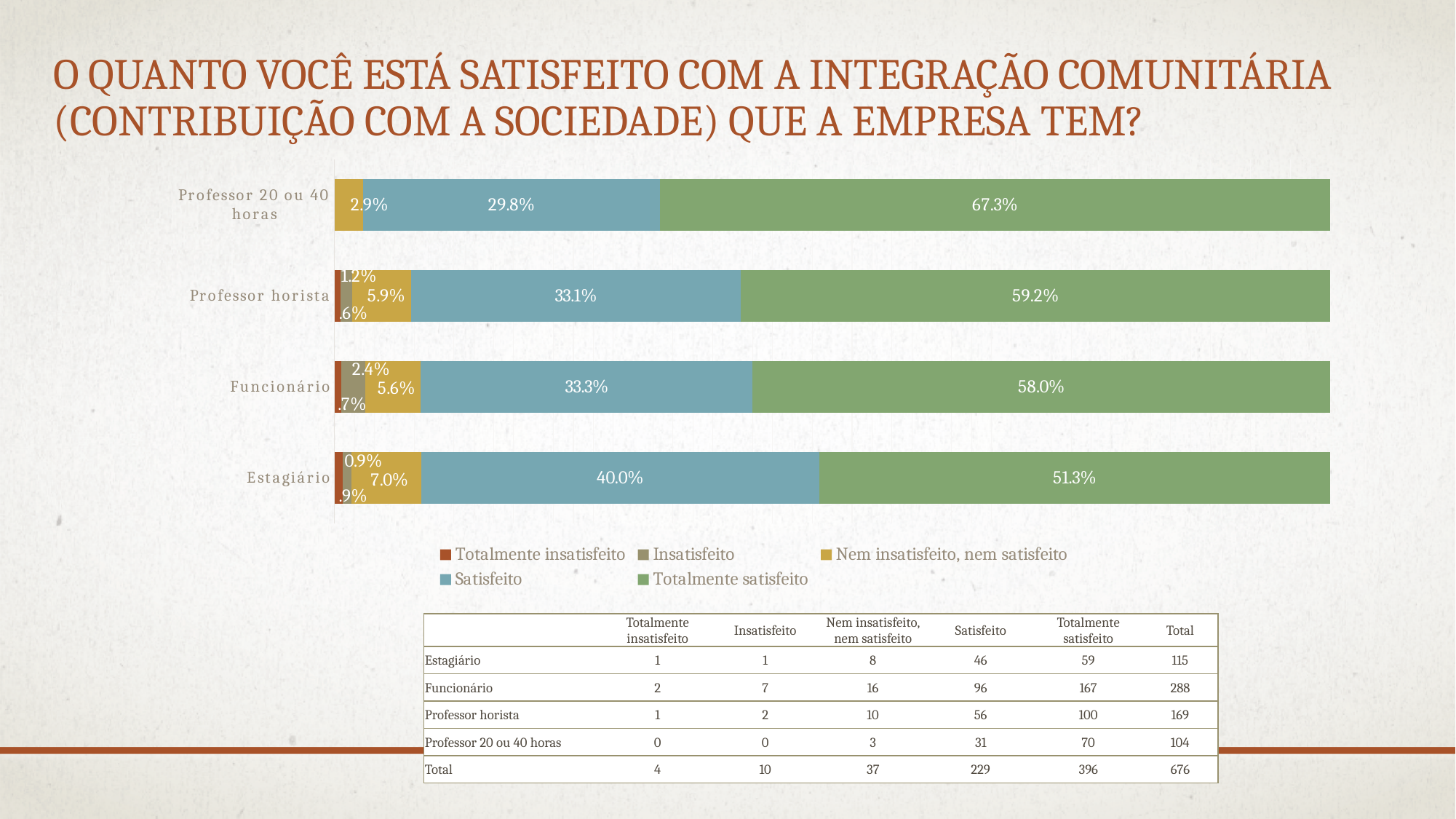
Which has a larger 'Nem insatisfeito, nem satisfeito' value, 'Estagiário' or 'Funcionário'? Estagiário How many percentage points higher is the 'Satisfeito' value for 'Estagiário' than for 'Professor 20 ou 40 horas'? 10.2 percentage points What kind of chart is shown on the slide? Stacked bar chart What is the 'Nem insatisfeito, nem satisfeito' value for 'Professor horista'? 5.9% What is the 'Satisfeito' value for 'Estagiário'? 40.0% Which colour represents 'Totalmente satisfeito' in the chart? Green What percentage of 'Professor 20 ou 40 horas' respondents are 'Totalmente satisfeito'? 67.3% Which category has the lowest 'Totalmente satisfeito' percentage? Estagiário What is the 'Satisfeito' value for 'Funcionário'? 33.3% How many series does the legend list? 5 Which category has the highest 'Totalmente satisfeito' percentage? Professor 20 ou 40 horas How many categories (groups of respondents) are shown in the chart? 4